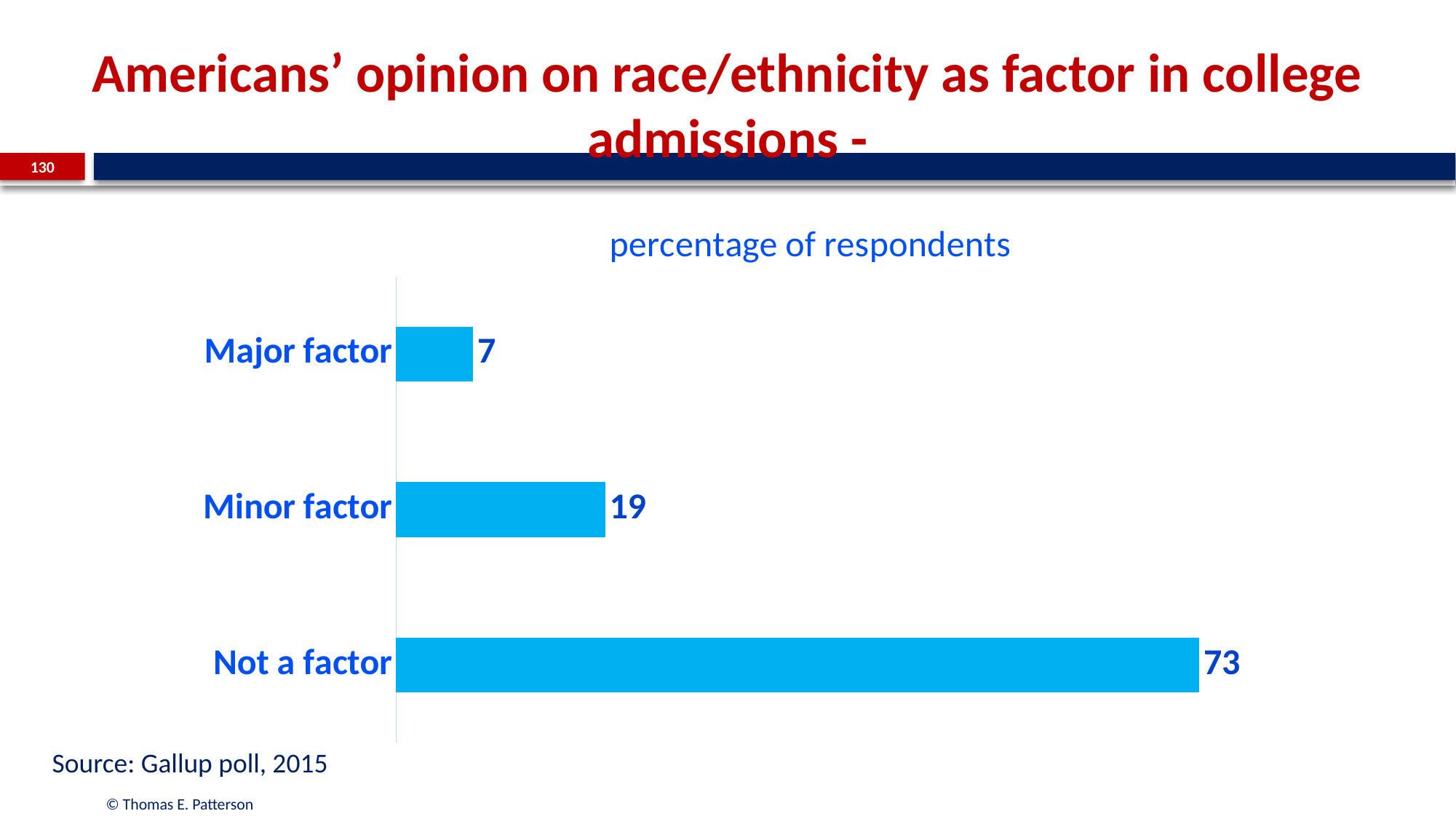
Which category has the highest value? Not a factor Which category has the lowest value? Major factor What source is cited for the chart data? Gallup poll, 2015 What is the difference between the values for Minor factor and Major factor? 12 Which is larger, the value for Minor factor or the value for Major factor? Minor factor What is the difference between the values for Not a factor and Minor factor? 54 What kind of chart is shown on the slide? bar chart What is the value for Not a factor? 73 What is the value for Minor factor? 19 What is the value for Major factor? 7 How many categories are shown in the chart? 3 What is the title of the chart? percentage of respondents